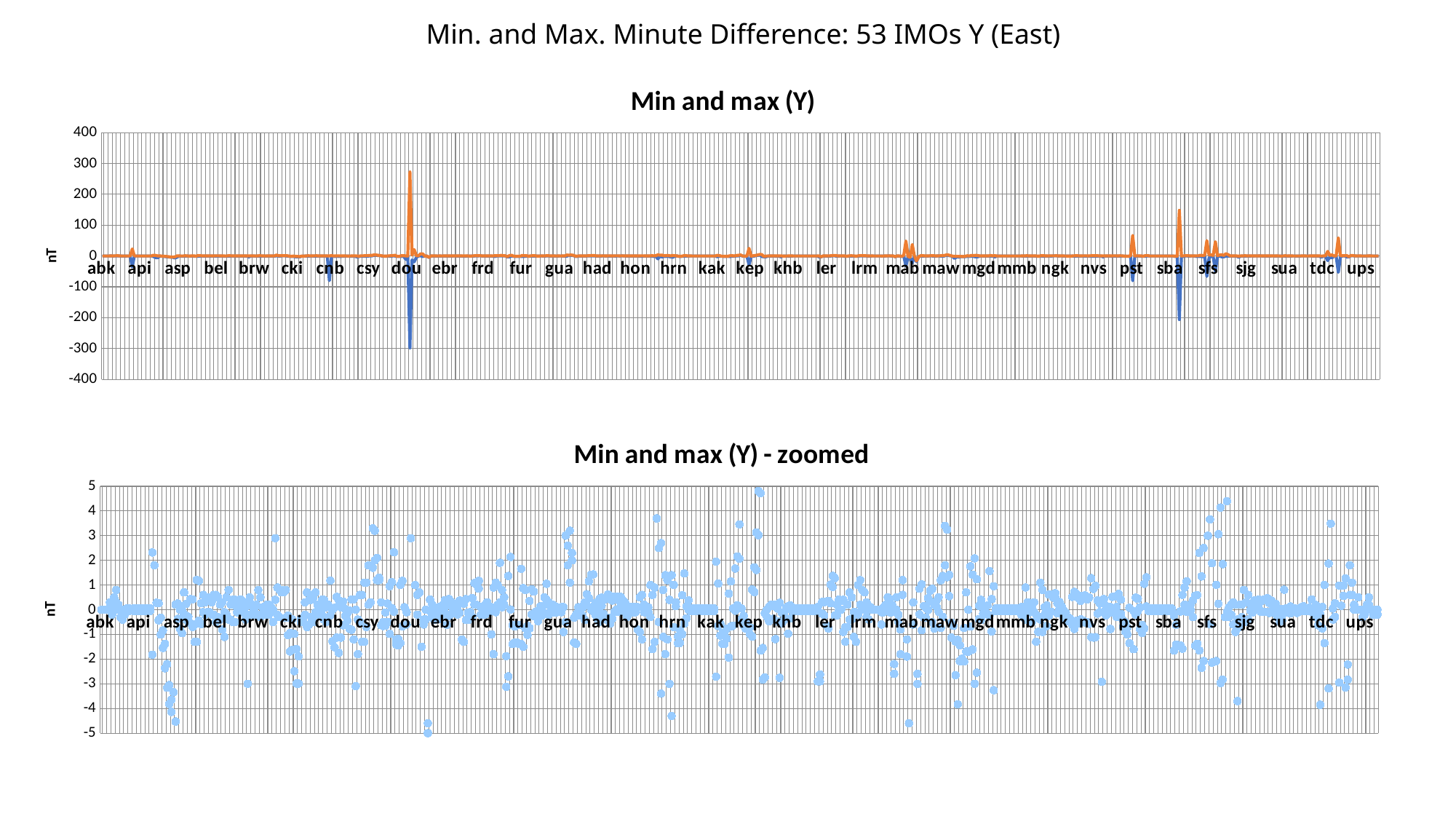
In the top chart 'Min and max (Y)', is the orange peak near dou greater or less than 200? greater In the top chart 'Min and max (Y)', near which station label does the blue series reach its lowest value? dou In the top chart 'Min and max (Y)', is the orange peak near sba greater or less than 100? greater In the top chart 'Min and max (Y)', near which station label does the orange series reach its highest peak? dou In the bottom chart 'Min and max (Y) - zoomed', is the highest point near kep greater or less than 4? greater In the bottom chart 'Min and max (Y) - zoomed', what kind of chart is it? scatter chart What is the title of the slide? Min. and Max. Minute Difference: 53 IMOs Y (East) In the top chart 'Min and max (Y)', which orange peak is larger, the one near dou or the one near sba? dou In the top chart 'Min and max (Y)', what kind of chart is it? line chart In the top chart 'Min and max (Y)', what is the label on the vertical axis? nT